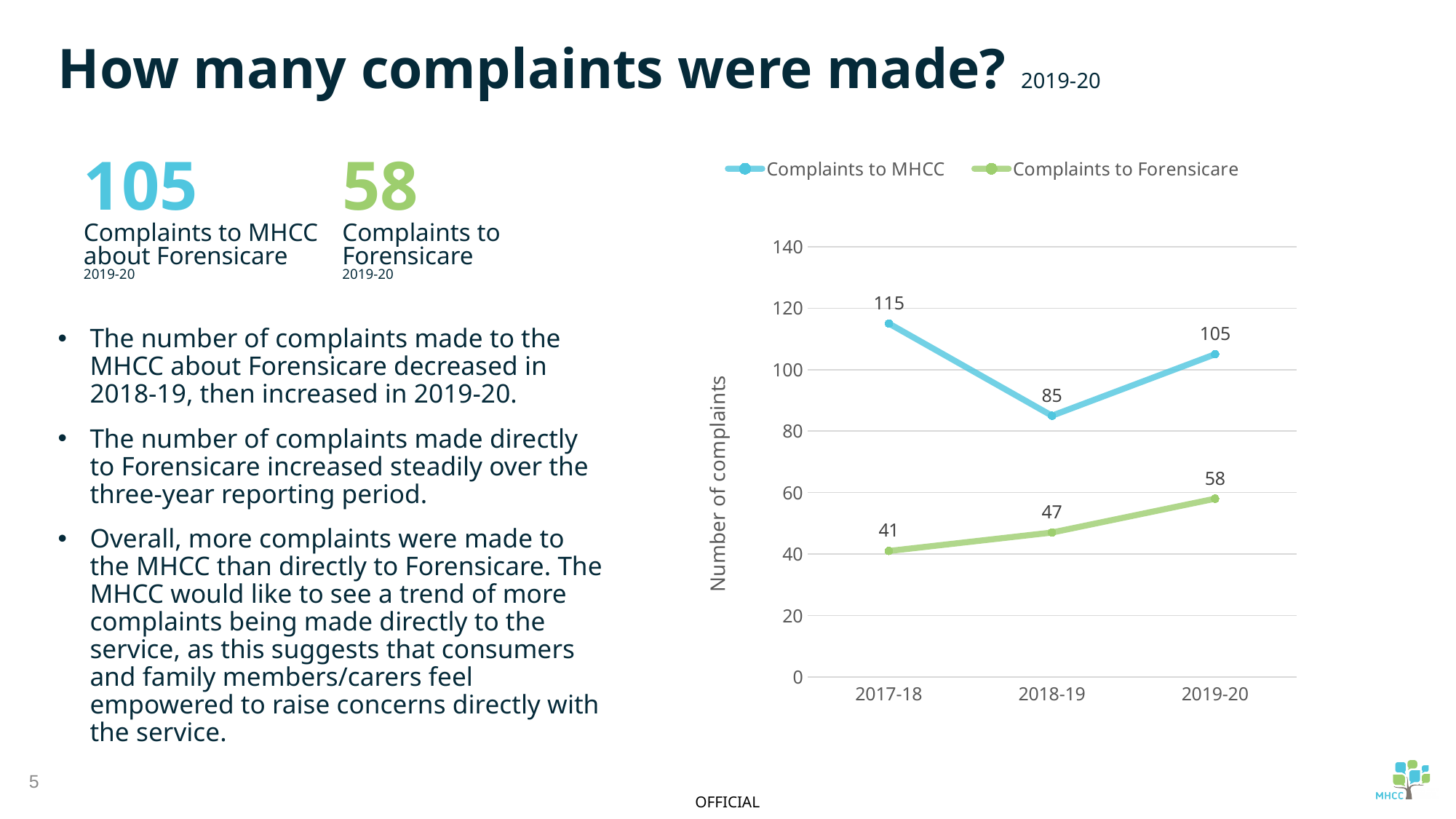
How many complaints were made to Forensicare in 2018-19? 47 How many series does the chart legend list? 2 Which series had more complaints in 2018-19, MHCC or Forensicare? Complaints to MHCC What type of chart is shown on the slide? Line chart In which year were complaints to Forensicare highest? 2019-20 How many complaints were made to MHCC in 2019-20? 105 What is the difference between complaints to MHCC and complaints to Forensicare in 2019-20? 47 In which year were complaints to MHCC lowest? 2018-19 Do complaints to Forensicare rise or fall from 2017-18 to 2019-20? Rise How many complaints were made to MHCC in 2017-18? 115 By how much did complaints to MHCC fall from 2017-18 to 2018-19? 30 How many years are shown on the x axis of the chart? 3